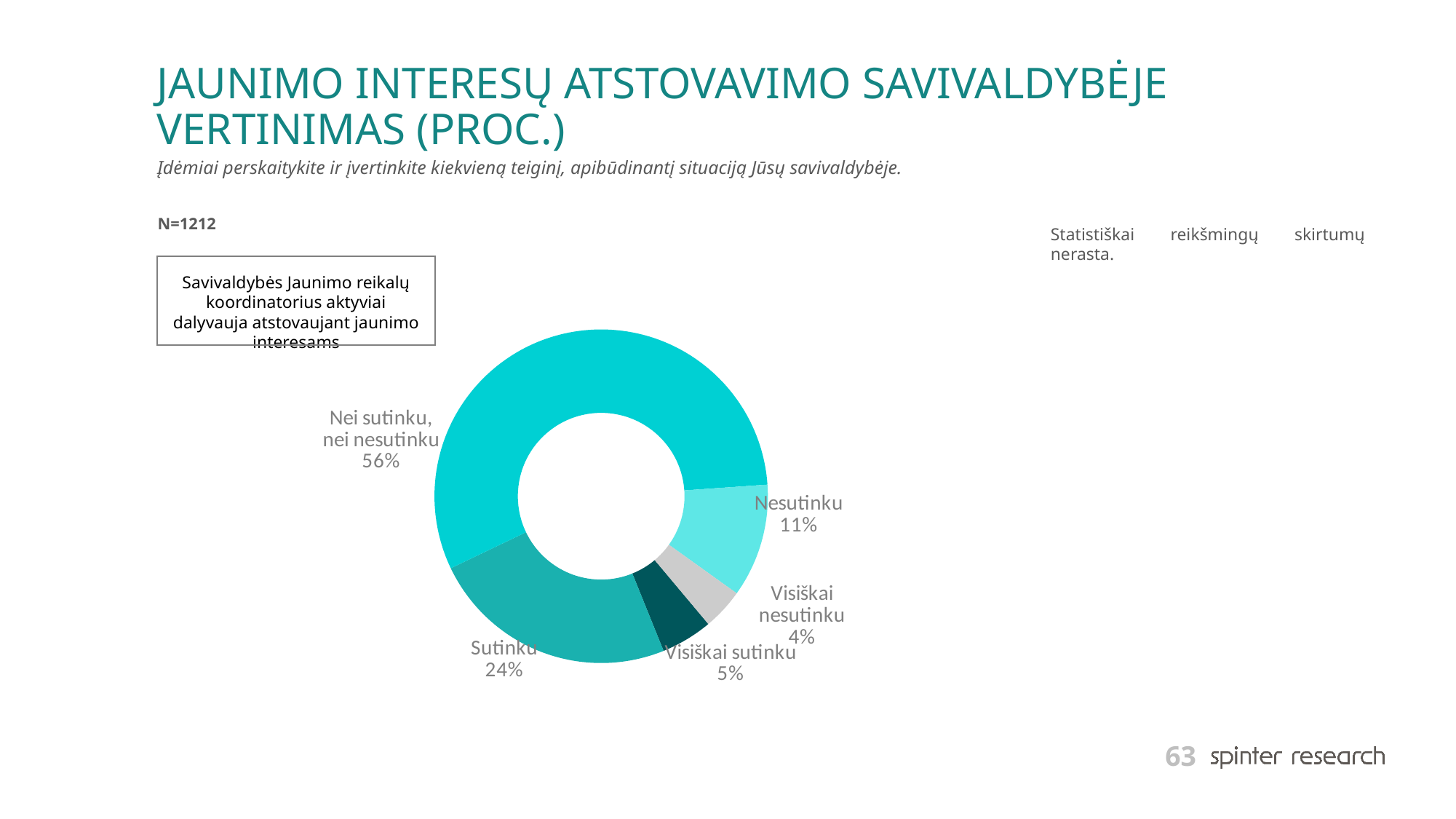
What is the sample size (N) stated on the slide? N=1212 Which response category has the largest share of the pie? Nei sutinku, nei nesutinku Which is larger, the share for "Sutinku" or the share for "Nesutinku"? Sutinku What share of respondents answered "Nesutinku"? 11% What is the difference in percentage points between "Nei sutinku, nei nesutinku" and "Sutinku"? 32 What kind of chart is shown on the slide? Pie chart (doughnut) What share of respondents answered "Sutinku"? 24% Which response category has the smallest share of the pie? Visiškai nesutinku What share of respondents answered "Visiškai nesutinku"? 4% How many response categories are shown in the chart? 5 What share of respondents answered "Visiškai sutinku"? 5% What share of respondents answered "Nei sutinku, nei nesutinku"? 56%